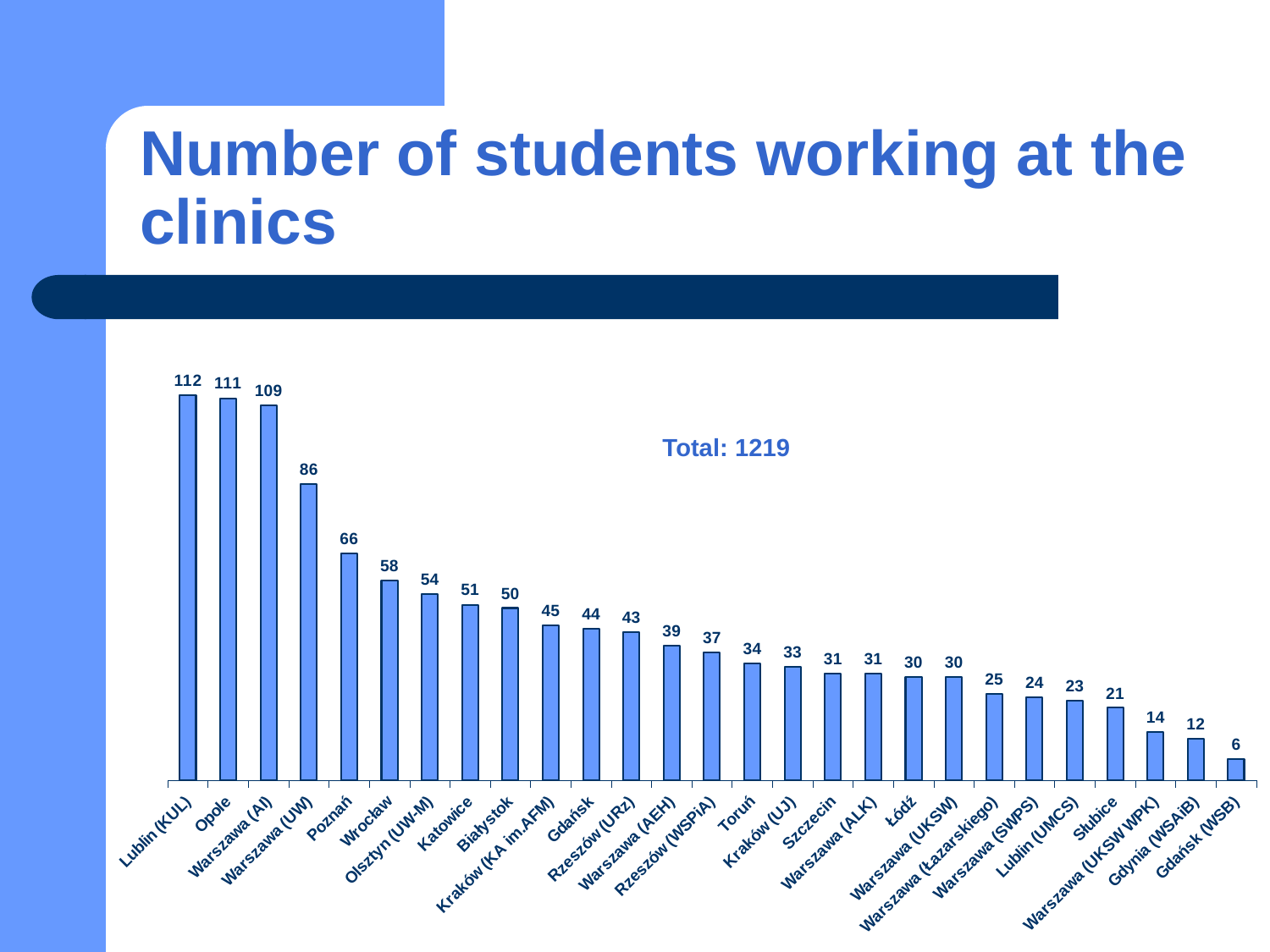
Do the values rise or fall from left to right along the x axis? Fall What is the number of students for Gdynia (WSAiB)? 12 What is the number of students for Warszawa (UW)? 86 What total number of students is stated on the chart? 1219 What is the number of students for Poznań? 66 Which clinic has the highest number of students? Lublin (KUL) What is the difference between the number of students at Lublin (KUL) and at Warszawa (UW)? 26 What is the number of students for Toruń? 34 Which has more students, Wrocław or Katowice? Wrocław Which clinic has the lowest number of students? Gdańsk (WSB) What kind of chart is shown on the slide? Bar chart How many clinics are shown on the chart? 27